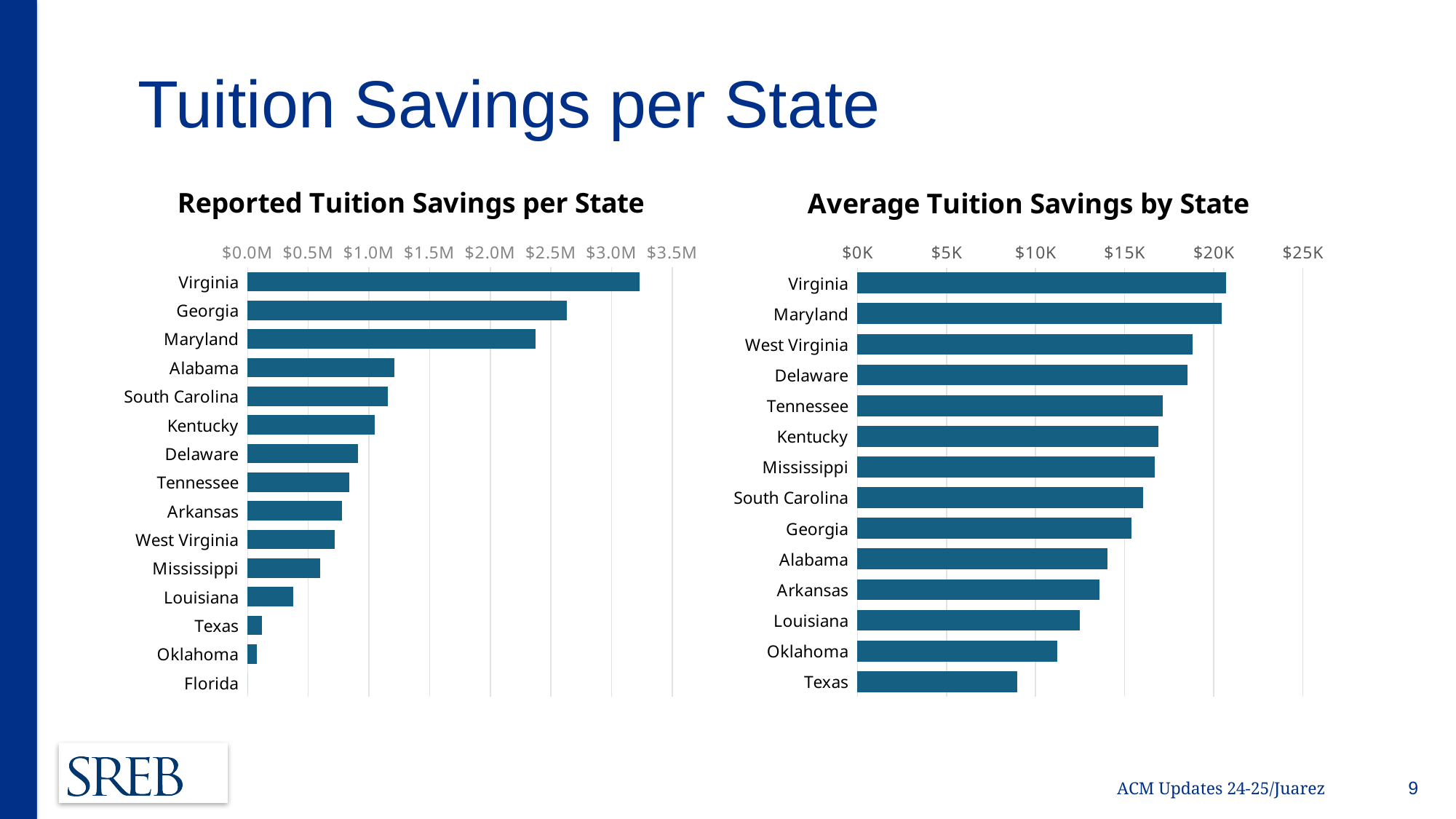
In the "Average Tuition Savings by State" chart, is the value for Texas greater or less than $10K? less In the "Reported Tuition Savings per State" chart, is the value for Louisiana greater or less than $0.5M? less In the "Average Tuition Savings by State" chart, is the value for West Virginia greater or less than $15K? greater In the "Average Tuition Savings by State" chart, which state has the lowest average tuition savings? Texas What kind of chart is the "Reported Tuition Savings per State" chart? bar chart In the "Reported Tuition Savings per State" chart, which is larger, the value for Georgia or the value for Maryland? Georgia In the "Reported Tuition Savings per State" chart, which state has the highest reported tuition savings? Virginia In the "Reported Tuition Savings per State" chart, which state has the lowest reported tuition savings? Florida How many states are listed in the "Reported Tuition Savings per State" chart? 15 What is the title of the chart on the right side of the slide? Average Tuition Savings by State How many states are listed in the "Average Tuition Savings by State" chart? 14